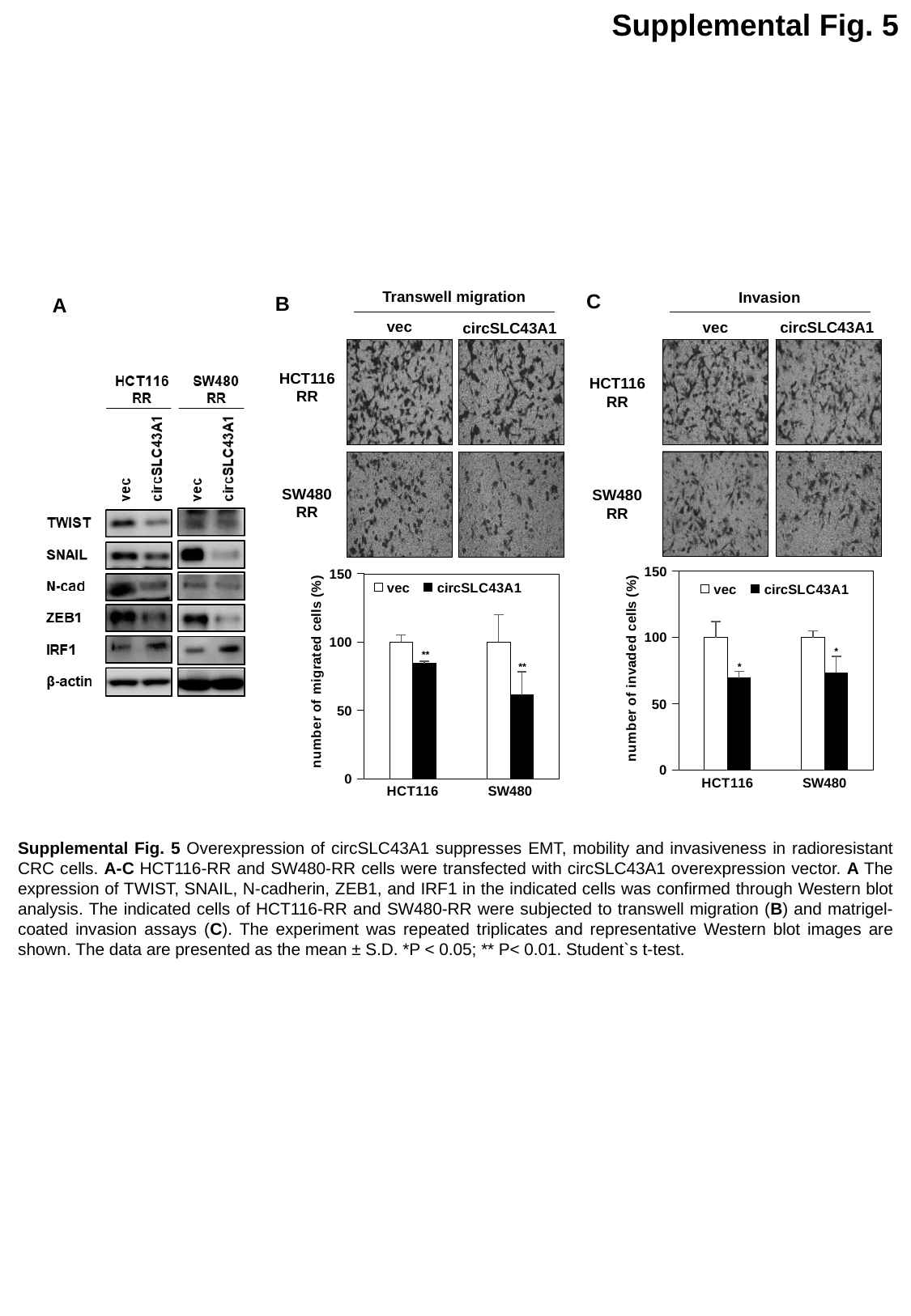
In the Invasion chart (panel C), is the value for circSLC43A1 in HCT116 greater or less than 100? less In the Transwell migration chart (panel B), what are the two legend entries? vec and circSLC43A1 In the Transwell migration chart (panel B), how many cell line categories are shown on the x axis? 2 In the Invasion chart (panel C), for HCT116, which series has the larger value, vec or circSLC43A1? vec In the Invasion chart (panel C), what is the y-axis title? number of invaded cells (%) In the Transwell migration chart (panel B), is the value for circSLC43A1 in HCT116 greater or less than 100? less In the Transwell migration chart (panel B), how many series does the legend list? 2 In the Transwell migration chart (panel B), which cell line has the larger circSLC43A1 value, HCT116 or SW480? HCT116 In the Invasion chart (panel C), is the value for circSLC43A1 in SW480 greater or less than 50? greater In the Invasion chart (panel C), how many cell line categories are shown on the x axis? 2 In the Transwell migration chart (panel B), what kind of chart is used to show the number of migrated cells? bar chart